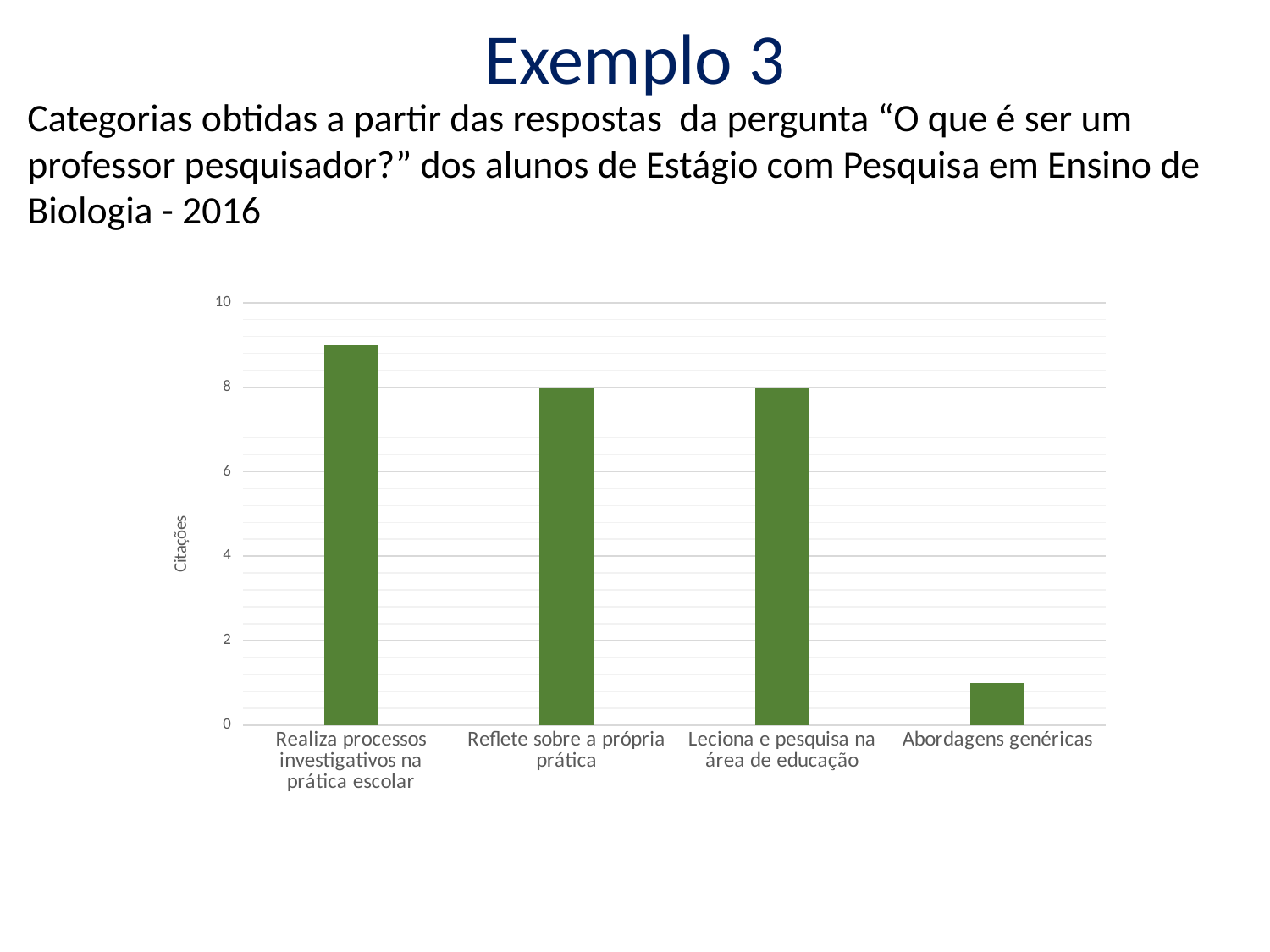
What is the value for "Reflete sobre a própria prática"? 8 Is the value for "Abordagens genéricas" greater or less than 2? less What type of chart is shown on the slide? Bar chart What is the highest value shown on the vertical axis of the chart? 10 Which category has the highest value? Realiza processos investigativos na prática escolar Which is larger: the value for "Realiza processos investigativos na prática escolar" or the value for "Reflete sobre a própria prática"? Realiza processos investigativos na prática escolar What is the difference between the values for "Reflete sobre a própria prática" and "Leciona e pesquisa na área de educação"? 0 Which category has the lowest value? Abordagens genéricas What is the label of the vertical axis of the chart? Citações What is the value for "Leciona e pesquisa na área de educação"? 8 Is the value for "Realiza processos investigativos na prática escolar" greater or less than 8? greater How many categories are shown on the x axis of the chart? 4